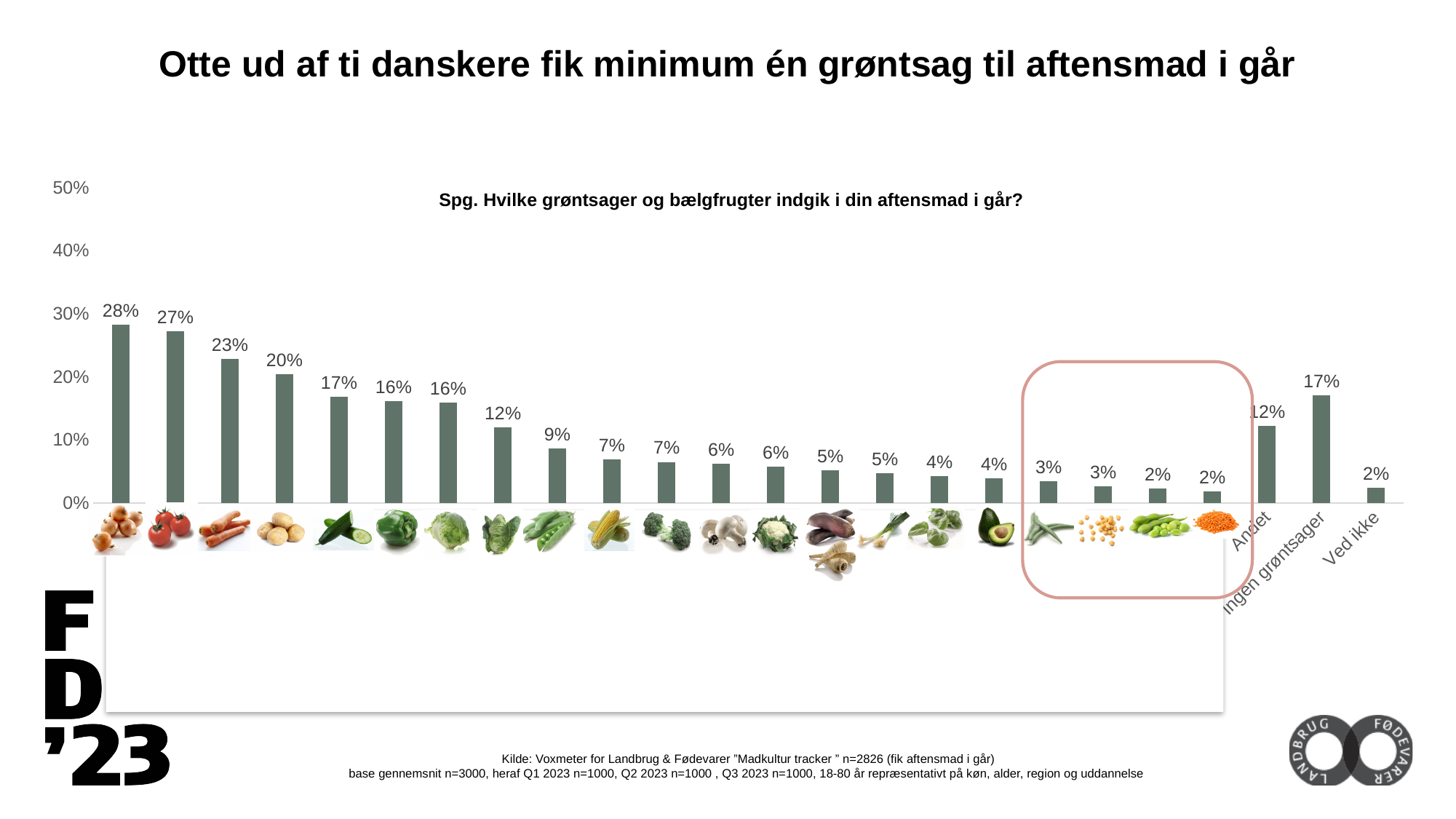
What is the value for "Ved ikke"? 2% Which is larger, the value for "Andet" or the value for "Ved ikke"? Andet What is the value of the leftmost bar in the chart? 28% Is the value for "Ingen grøntsager" greater or less than 10%? greater How many bars are plotted in the chart? 24 What is the difference between the values for "Andet" and "Ved ikke"? 10 percentage points What kind of chart is shown on the slide? bar chart What is the highest value shown in the chart? 28% What survey question is shown as the chart's title? Spg. Hvilke grøntsager og bælgfrugter indgik i din aftensmad i går? What is the value for "Ingen grøntsager"? 17% What is the difference between the values for "Ingen grøntsager" and "Andet"? 5 percentage points What is the value for "Andet"? 12%